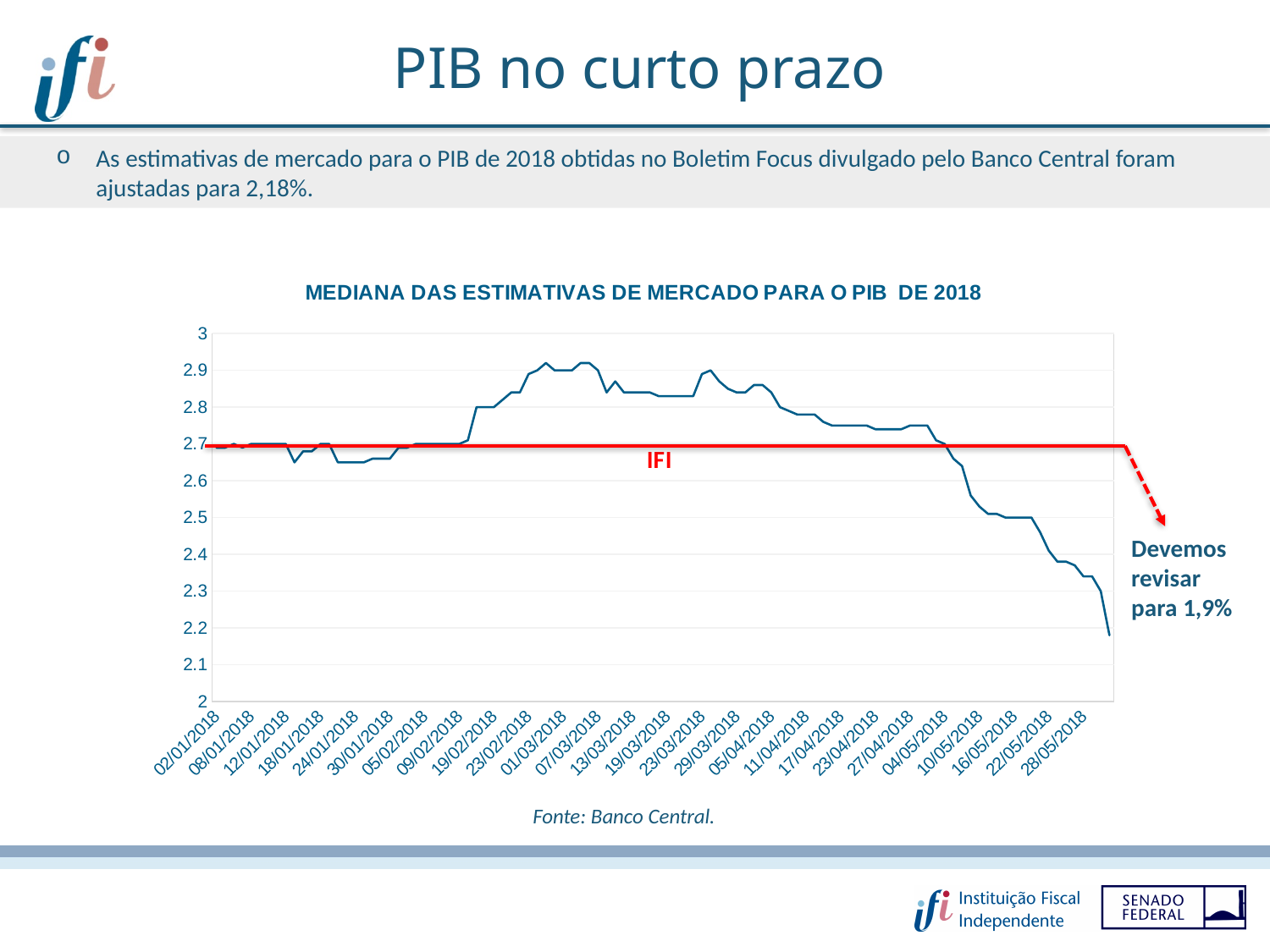
Which is larger, the value at 23/02/2018 or the value at 23/04/2018? 23/02/2018 Is the lowest value of the series at the beginning or at the end of the x axis? end What is the title of the chart? MEDIANA DAS ESTIMATIVAS DE MERCADO PARA O PIB DE 2018 Is the value at 16/05/2018 greater or less than 2.6? less What kind of chart is shown on the slide? line chart Is the value at 23/02/2018 greater or less than 2.7? greater Comparing the start of the series with the end, do the values rise or fall overall? fall Is the value at 07/03/2018 greater or less than 2.8? greater Which is larger, the value at 02/01/2018 or the value at 28/05/2018? 02/01/2018 What label is attached to the red horizontal line in the chart? IFI